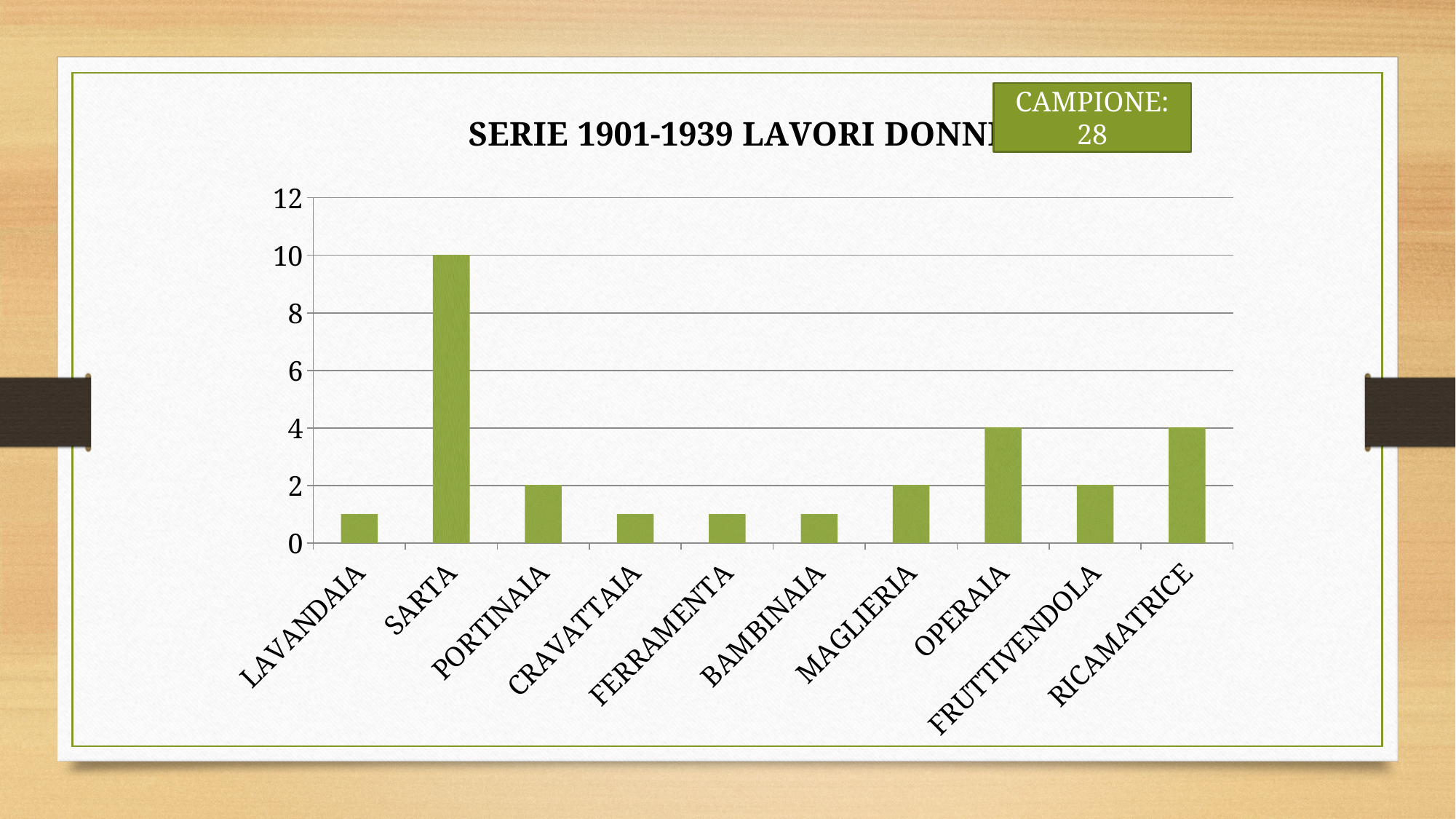
What is the value for OPERAIA? 4 What is the value for RICAMATRICE? 4 Which is larger, the value for OPERAIA or the value for MAGLIERIA? OPERAIA Which category has the highest value in the chart? SARTA Is the value for SARTA greater or less than 8? greater What is the value for PORTINAIA? 2 What is the value for SARTA? 10 Is the value for LAVANDAIA greater or less than 2? less What kind of chart is shown on the slide? bar chart How many categories are shown on the x axis of the chart? 10 What is the value for FRUTTIVENDOLA? 2 What is the difference between the values for SARTA and OPERAIA? 6